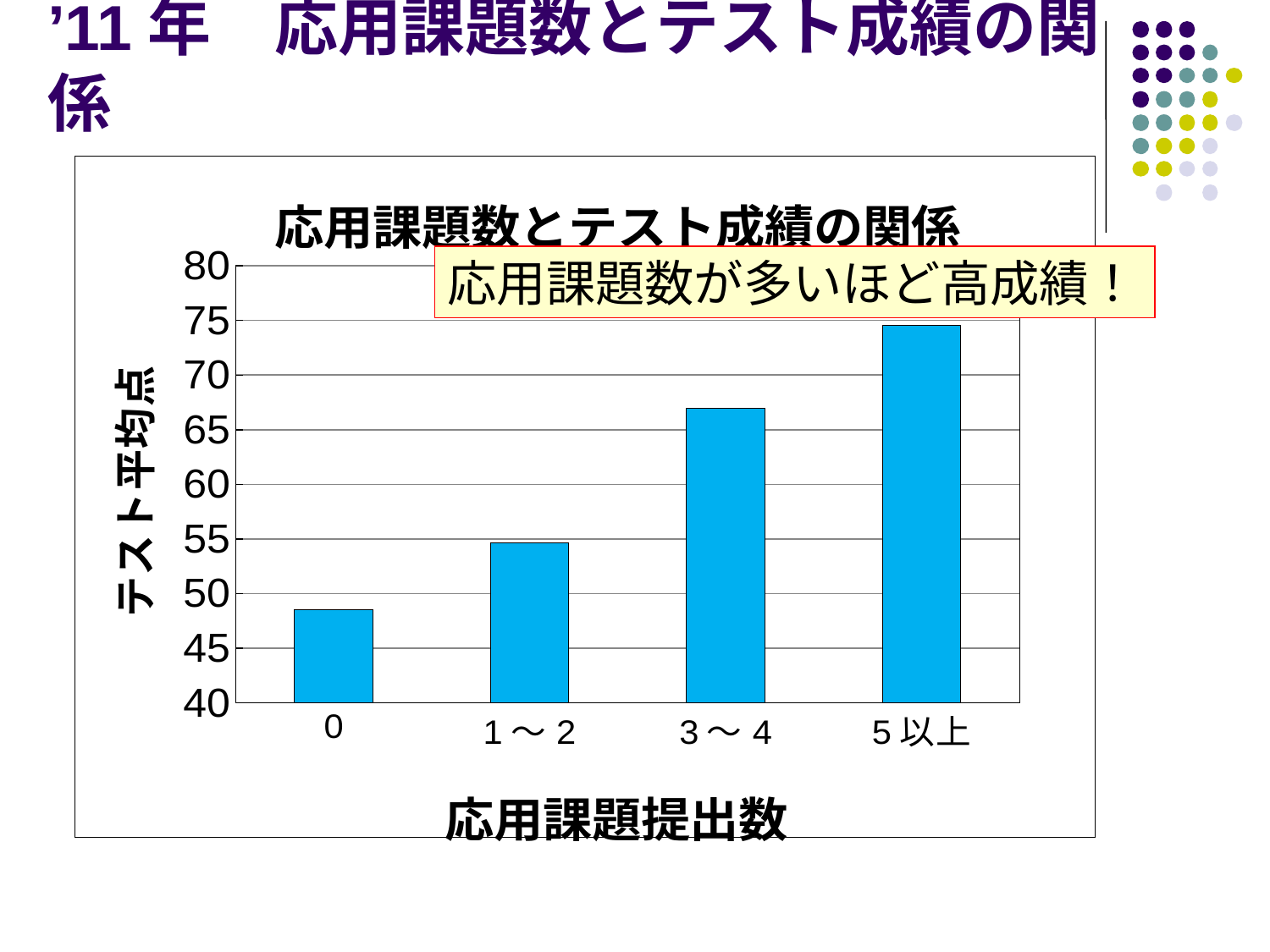
Do the values rise or fall as the number of submitted applied assignments increases along the x axis? rise Is the value for the category 3～4 greater or less than 65? greater What kind of chart is shown on the slide? bar chart Which category has the highest average test score (テスト平均点)? 5以上 How many categories are shown on the x axis of the chart? 4 Which category has the lowest average test score (テスト平均点)? 0 Is the value for the category 0 greater or less than 50? less Is the value for the category 5以上 greater or less than 70? greater Which has a higher average test score, the category 1～2 or the category 3～4? 3～4 What is the title of the chart? 応用課題数とテスト成績の関係 What is the label of the x axis of the chart? 応用課題提出数